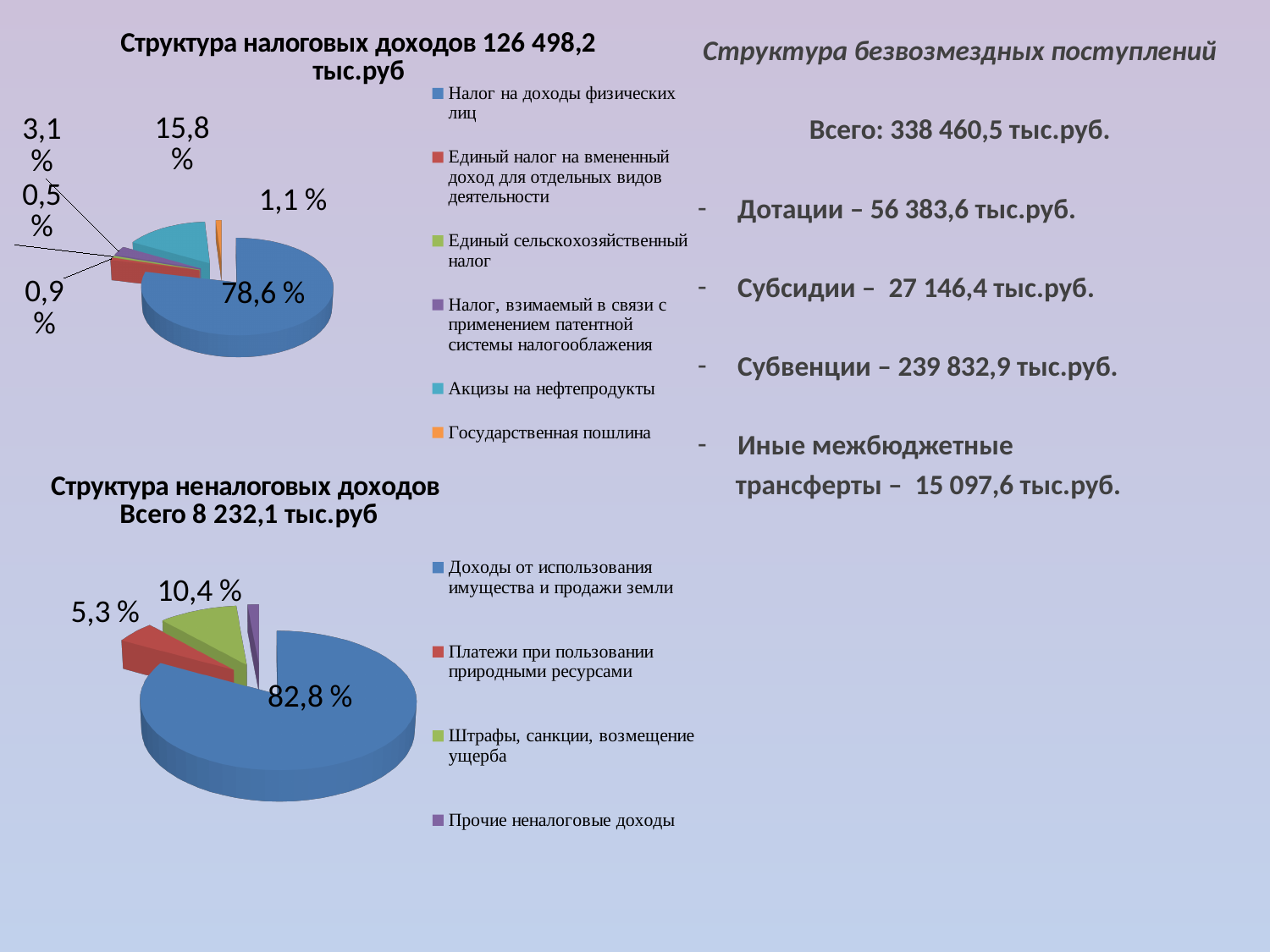
In the chart 'Структура неналоговых доходов', what share does 'Штрафы, санкции, возмещение ущерба' have? 10,4 % In the chart 'Структура неналоговых доходов', what share does 'Платежи при пользовании природными ресурсами' have? 5,3 % What type of chart is 'Структура неналоговых доходов'? Pie chart What total amount is stated in the title of the chart 'Структура неналоговых доходов'? 8 232,1 тыс.руб In the chart 'Структура налоговых доходов', what is the difference between the shares of 'Налог на доходы физических лиц' and 'Акцизы на нефтепродукты'? 62,8 % In the chart 'Структура налоговых доходов', which category has the largest slice? Налог на доходы физических лиц In the chart 'Структура неналоговых доходов', what share does 'Доходы от использования имущества и продажи земли' have? 82,8 % In the chart 'Структура налоговых доходов', how many entries does the legend list? 6 In the chart 'Структура неналоговых доходов', which is larger: 'Штрафы, санкции, возмещение ущерба' or 'Платежи при пользовании природными ресурсами'? Штрафы, санкции, возмещение ущерба In the chart 'Структура налоговых доходов', what share does 'Налог на доходы физических лиц' have? 78,6 % In the chart 'Структура налоговых доходов', what share does 'Государственная пошлина' have? 1,1 % In the chart 'Структура налоговых доходов', what share does 'Акцизы на нефтепродукты' have? 15,8 %